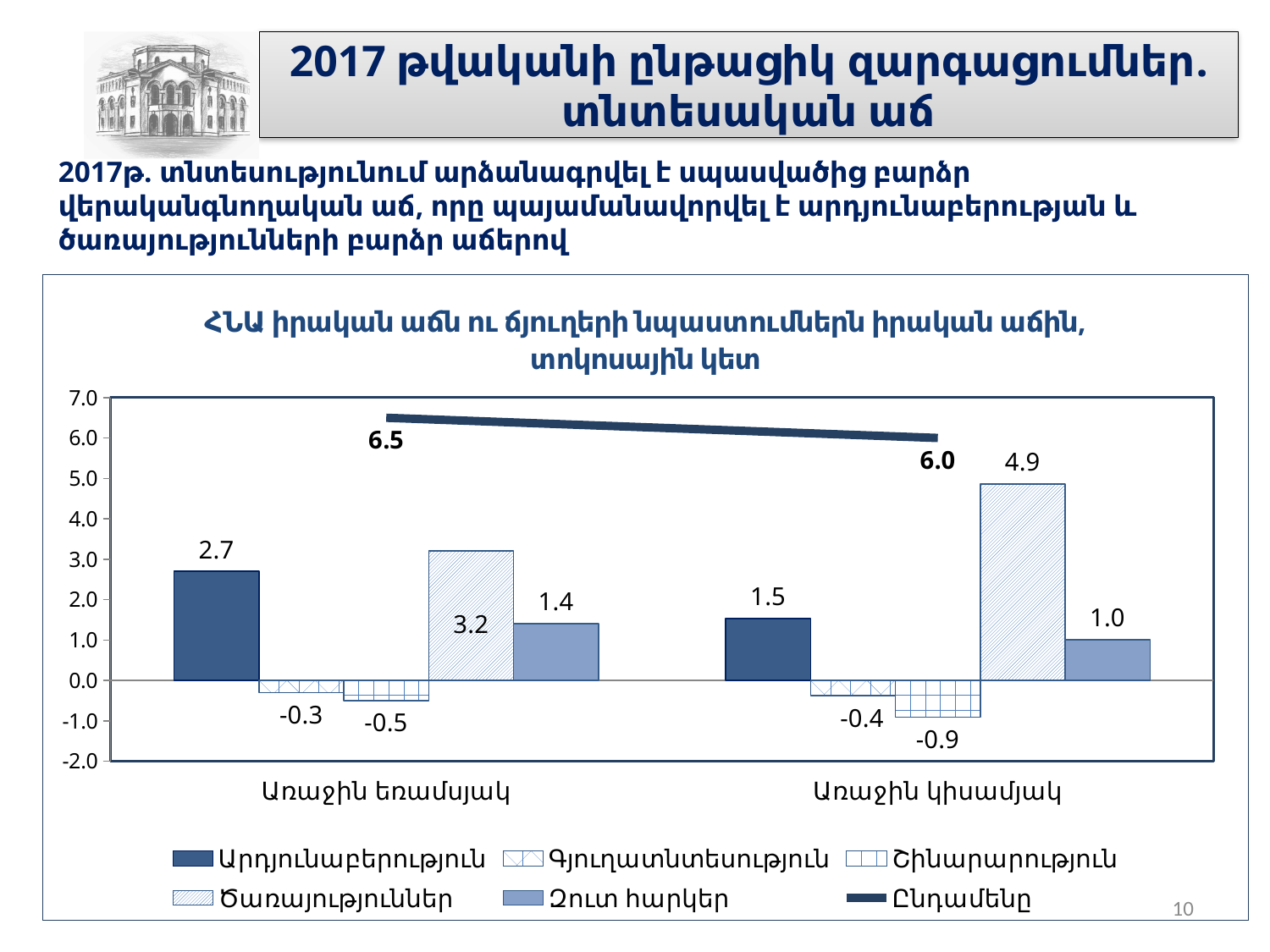
Which is larger: Զուտ հարկեր in Առաջին եռամսյակ or in Առաջին կիսամյակ? Առաջին եռամսյակ Which series has the lowest value in Առաջին եռամսյակ? Շինարարություն What kind of chart is shown on the slide? bar chart with a line What is the value of the Ընդամենը line for Առաջին եռամսյակ? 6.5 What is the value for Շինարարություն in Առաջին կիսամյակ? -0.9 How many categories are shown on the x axis? 2 What is the value for Արդյունաբերություն in Առաջին եռամսյակ? 2.7 What is the difference between the Ընդամենը values for Առաջին եռամսյակ and Առաջին կիսամյակ? 0.5 How many series does the legend list? 6 What is the value for Ծառայություններ in Առաջին կիսամյակ? 4.9 Which series has the highest value in Առաջին կիսամյակ? Ընդամենը Does the Ընդամենը line rise or fall from Առաջին եռամսյակ to Առաջին կիսամյակ? fall